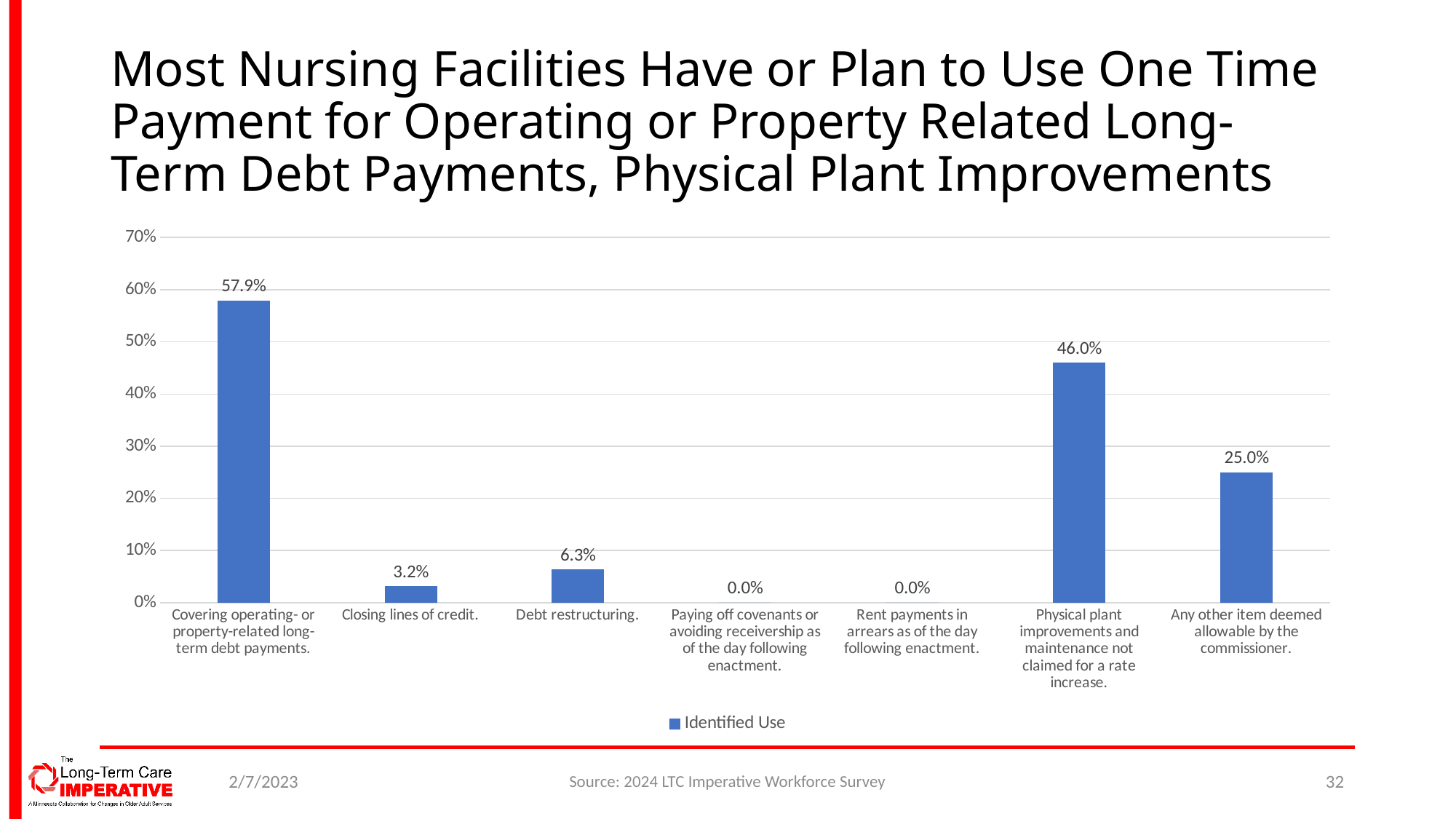
What series name does the legend show? Identified Use How many categories have a value of 0.0%? 2 What kind of chart is shown on the slide? bar chart Is the value for "Any other item deemed allowable by the commissioner." greater or less than 30%? less What is the value for "Debt restructuring."? 6.3% What is the value for "Covering operating- or property-related long-term debt payments."? 57.9% What is the value for "Physical plant improvements and maintenance not claimed for a rate increase."? 46.0% How many categories are shown on the x axis? 7 What is the value for "Closing lines of credit."? 3.2% What is the difference between the values for "Covering operating- or property-related long-term debt payments." and "Physical plant improvements and maintenance not claimed for a rate increase."? 11.9% Which is larger, the value for "Debt restructuring." or the value for "Closing lines of credit."? Debt restructuring. Which category has the highest value? Covering operating- or property-related long-term debt payments.